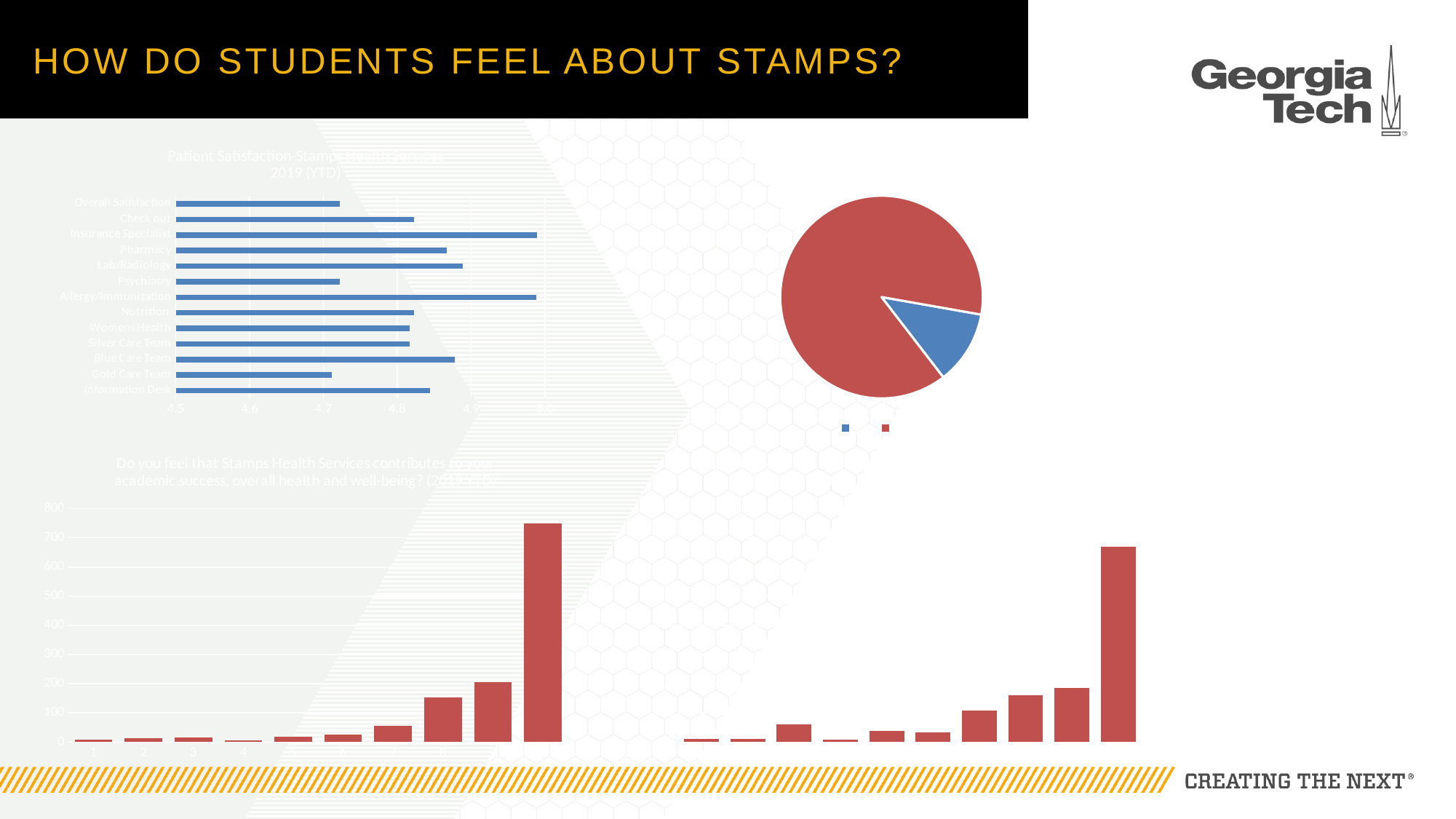
How many slices does the pie chart in the top-right of the slide have? 2 What kind of chart is the chart in the top-right of the slide? pie chart In the bottom-left 'Do you feel that Stamps Health Services contributes...' chart, is the tallest bar greater or less than 700? greater In the top-left 'Patient Satisfaction' chart, which is larger, Blue Care Team or Gold Care Team? Blue Care Team In the top-left 'Patient Satisfaction' chart, is the value for Insurance Specialist greater or less than 4.9? greater In the top-left 'Patient Satisfaction' chart, which is larger, Insurance Specialist or Psychiatry? Insurance Specialist What kind of chart is the chart in the bottom-right of the slide? bar chart How many categories are plotted in the top-left 'Patient Satisfaction' bar chart? 13 In the bottom-left chart titled 'Do you feel that Stamps Health Services contributes to your academic success, overall health and well-being? (2019 YTD)', do the values generally rise or fall along the x axis? rise In the top-left 'Patient Satisfaction' chart, is the value for Overall Satisfaction greater or less than 4.8? less In the top-right pie chart, which slice is larger, the red one or the blue one? red What kind of chart is the top-left chart titled 'Patient Satisfaction-Stamps Health Services 2019 (YTD)'? bar chart